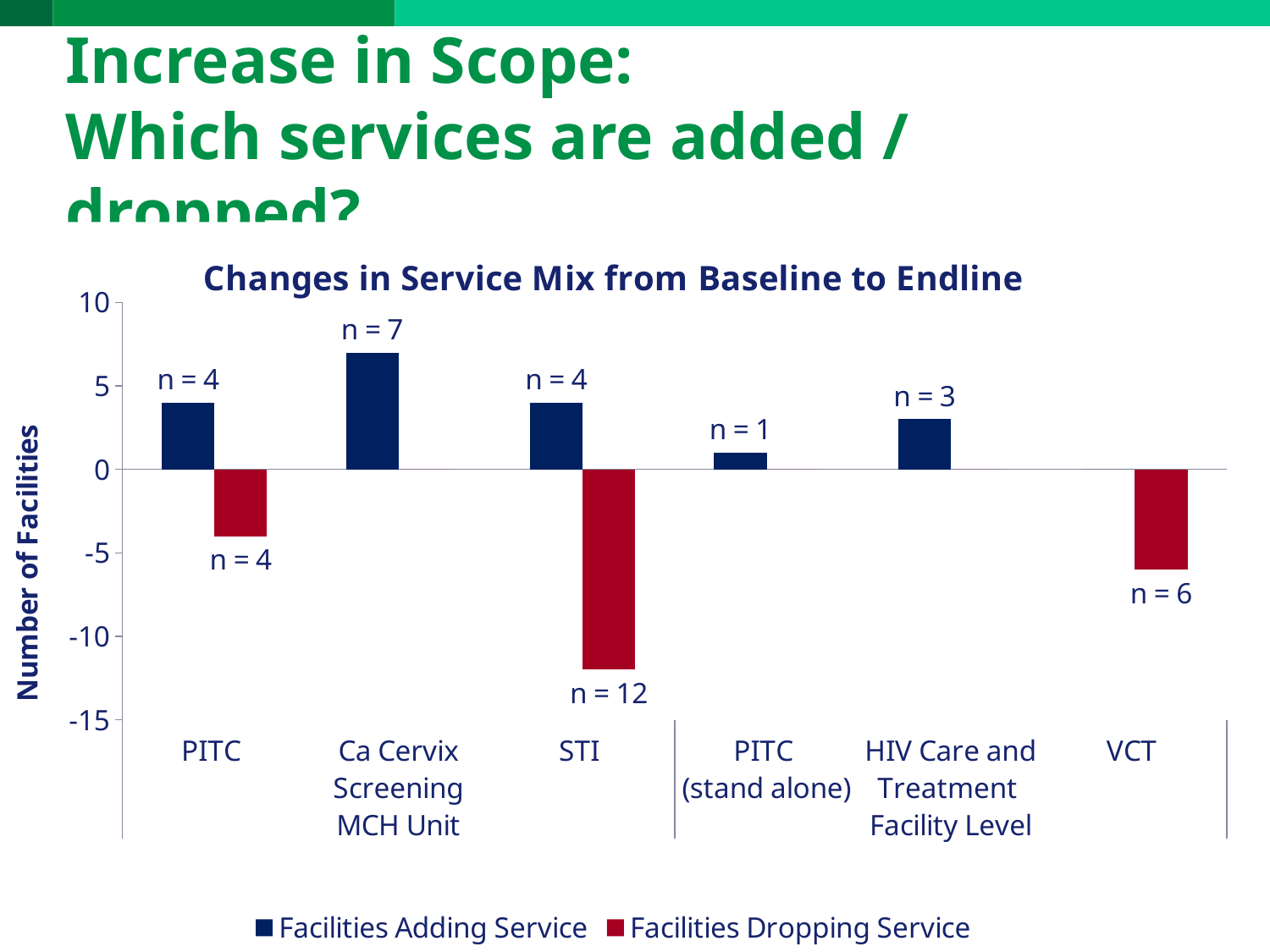
How many series does the legend list? 2 For STI, how many more facilities dropped the service than added it? 8 Which service has the largest number of facilities dropping it? STI How many service categories are shown on the x axis? 6 What type of chart is shown on the slide? Bar chart Which is larger: the number of facilities dropping VCT or the number dropping PITC? VCT How many facilities dropped the STI service? n = 12 Which service has the highest number of facilities adding it? Ca Cervix Screening MCH Unit How many facilities dropped the VCT service? n = 6 How many facilities added the Ca Cervix Screening MCH Unit service? n = 7 What is the value for Facilities Adding Service for HIV Care and Treatment Facility Level? n = 3